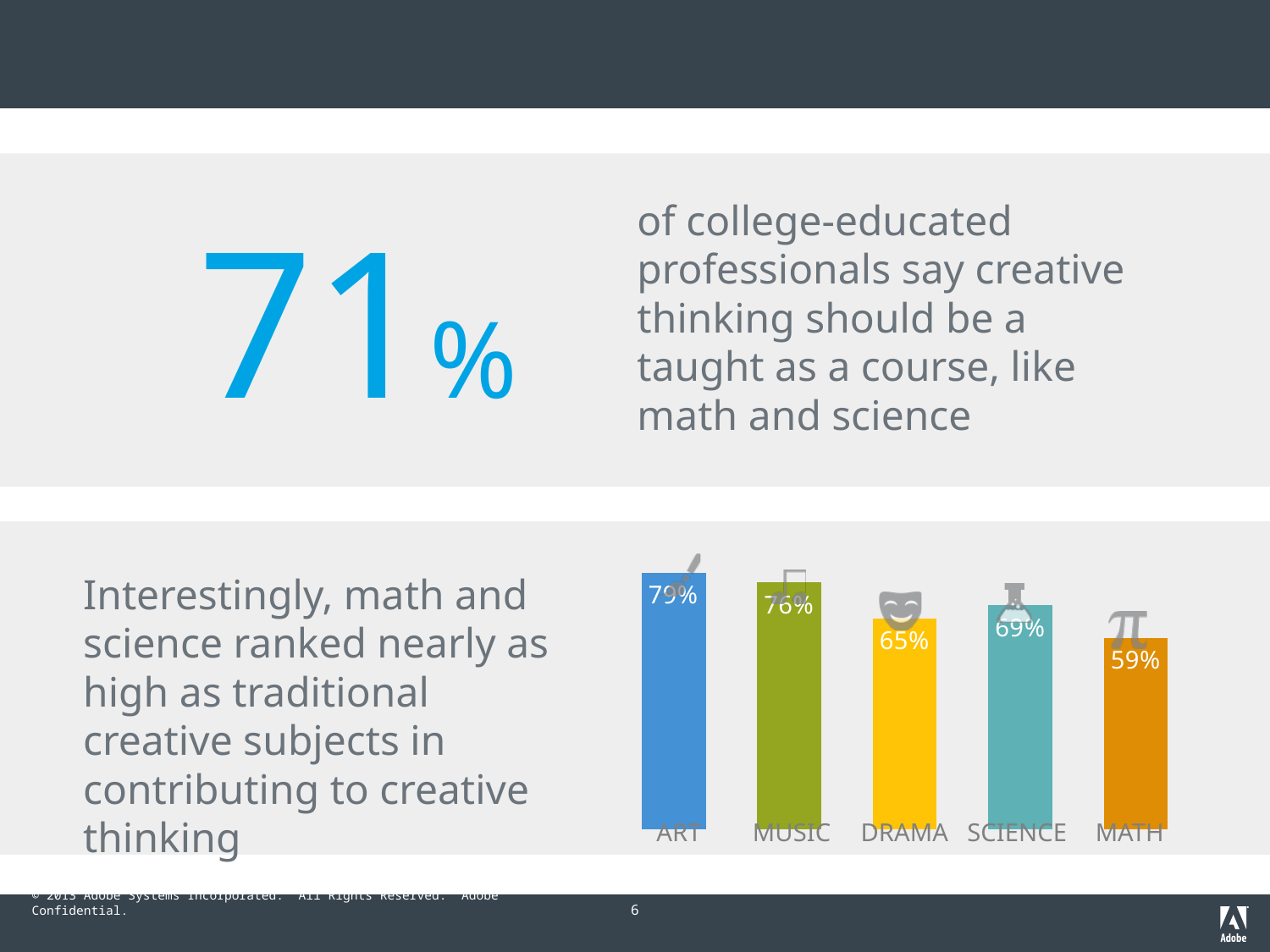
What is the difference between the values for ART and MATH? 20% Which category has the lowest value in the bar chart? MATH What is the difference between the values for SCIENCE and DRAMA? 4% How many categories are shown in the bar chart? 5 What kind of chart is shown on the slide? Bar chart What percentage is shown for SCIENCE in the bar chart? 69% Which has a higher value, SCIENCE or MATH? SCIENCE What percentage is shown for ART in the bar chart? 79% What percentage is shown for MATH in the bar chart? 59% Which category has the highest value in the bar chart? ART What colour is the bar for DRAMA? Yellow Which has a higher value, MUSIC or DRAMA? MUSIC